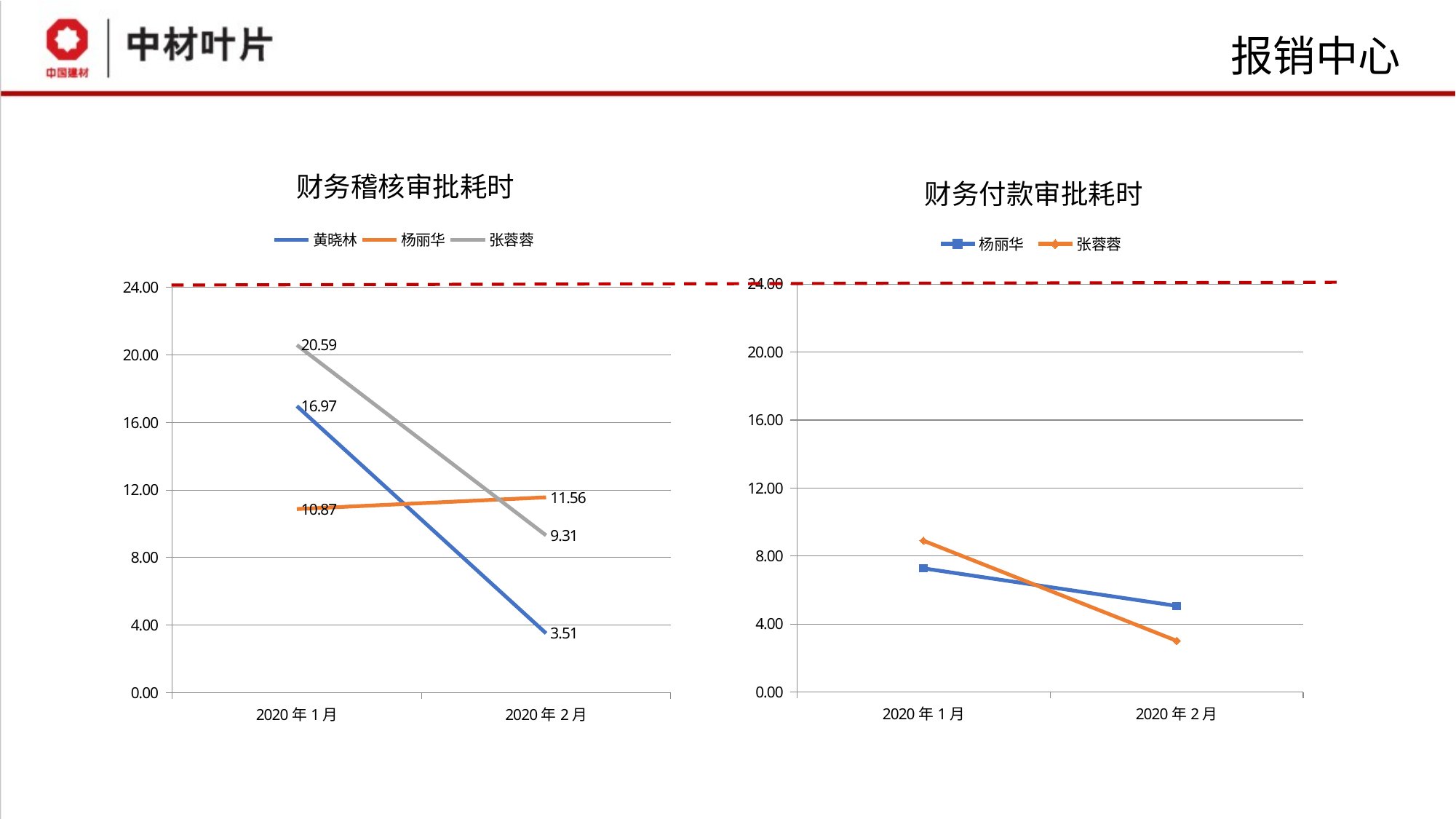
In the chart titled 财务稽核审批耗时, what is the difference between the 2020年1月 and 2020年2月 values for 黄晓林? 13.46 In the chart titled 财务付款审批耗时, is the value for 张蓉蓉 in 2020年1月 greater or less than 8.00? greater In the chart titled 财务稽核审批耗时, does the value for 杨丽华 rise or fall from 2020年1月 to 2020年2月? rise How many series does the legend of the chart titled 财务付款审批耗时 list? 2 In the chart titled 财务稽核审批耗时, which series has the lowest value in 2020年2月? 黄晓林 How many series does the legend of the chart titled 财务稽核审批耗时 list? 3 In the chart titled 财务付款审批耗时, which series has the lower value in 2020年2月, 杨丽华 or 张蓉蓉? 张蓉蓉 In the chart titled 财务稽核审批耗时, which series has the highest value in 2020年1月? 张蓉蓉 In the chart titled 财务稽核审批耗时, what is the value for 张蓉蓉 in 2020年2月? 9.31 In the chart titled 财务稽核审批耗时, what is the value for 杨丽华 in 2020年1月? 10.87 In the chart titled 财务稽核审批耗时, what is the value for 黄晓林 in 2020年1月? 16.97 What kind of chart is the chart titled 财务付款审批耗时? line chart